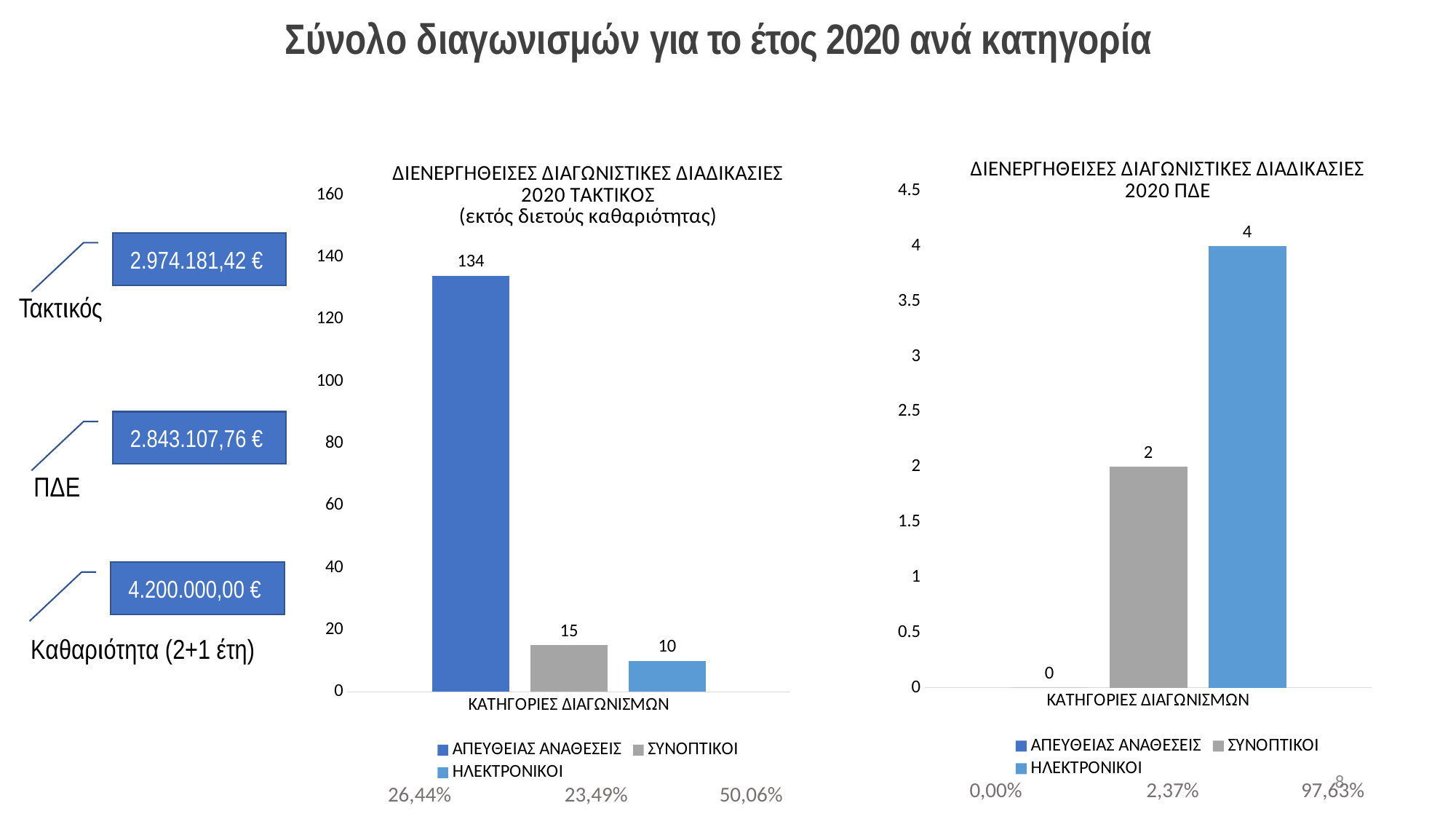
In the 2020 ΠΔΕ chart, what is the value for ΣΥΝΟΠΤΙΚΟΙ? 2 In the 2020 ΤΑΚΤΙΚΟΣ chart, what is the difference between ΑΠΕΥΘΕΙΑΣ ΑΝΑΘΕΣΕΙΣ and ΣΥΝΟΠΤΙΚΟΙ? 119 What kind of chart is the 2020 ΤΑΚΤΙΚΟΣ chart? bar chart In the 2020 ΤΑΚΤΙΚΟΣ chart, what is the value for ΑΠΕΥΘΕΙΑΣ ΑΝΑΘΕΣΕΙΣ? 134 In the 2020 ΠΔΕ chart, which series has the lowest value? ΑΠΕΥΘΕΙΑΣ ΑΝΑΘΕΣΕΙΣ In the 2020 ΠΔΕ chart, which is larger, ΣΥΝΟΠΤΙΚΟΙ or ΗΛΕΚΤΡΟΝΙΚΟΙ? ΗΛΕΚΤΡΟΝΙΚΟΙ In the 2020 ΤΑΚΤΙΚΟΣ chart, is the value for ΑΠΕΥΘΕΙΑΣ ΑΝΑΘΕΣΕΙΣ greater or less than 120? greater How many series does the legend of the 2020 ΠΔΕ chart list? 3 In the 2020 ΠΔΕ chart, what is the value for ΗΛΕΚΤΡΟΝΙΚΟΙ? 4 In the 2020 ΤΑΚΤΙΚΟΣ chart, what is the value for ΣΥΝΟΠΤΙΚΟΙ? 15 In the 2020 ΤΑΚΤΙΚΟΣ chart, what is the value for ΗΛΕΚΤΡΟΝΙΚΟΙ? 10 In the 2020 ΤΑΚΤΙΚΟΣ chart, which series has the highest value? ΑΠΕΥΘΕΙΑΣ ΑΝΑΘΕΣΕΙΣ